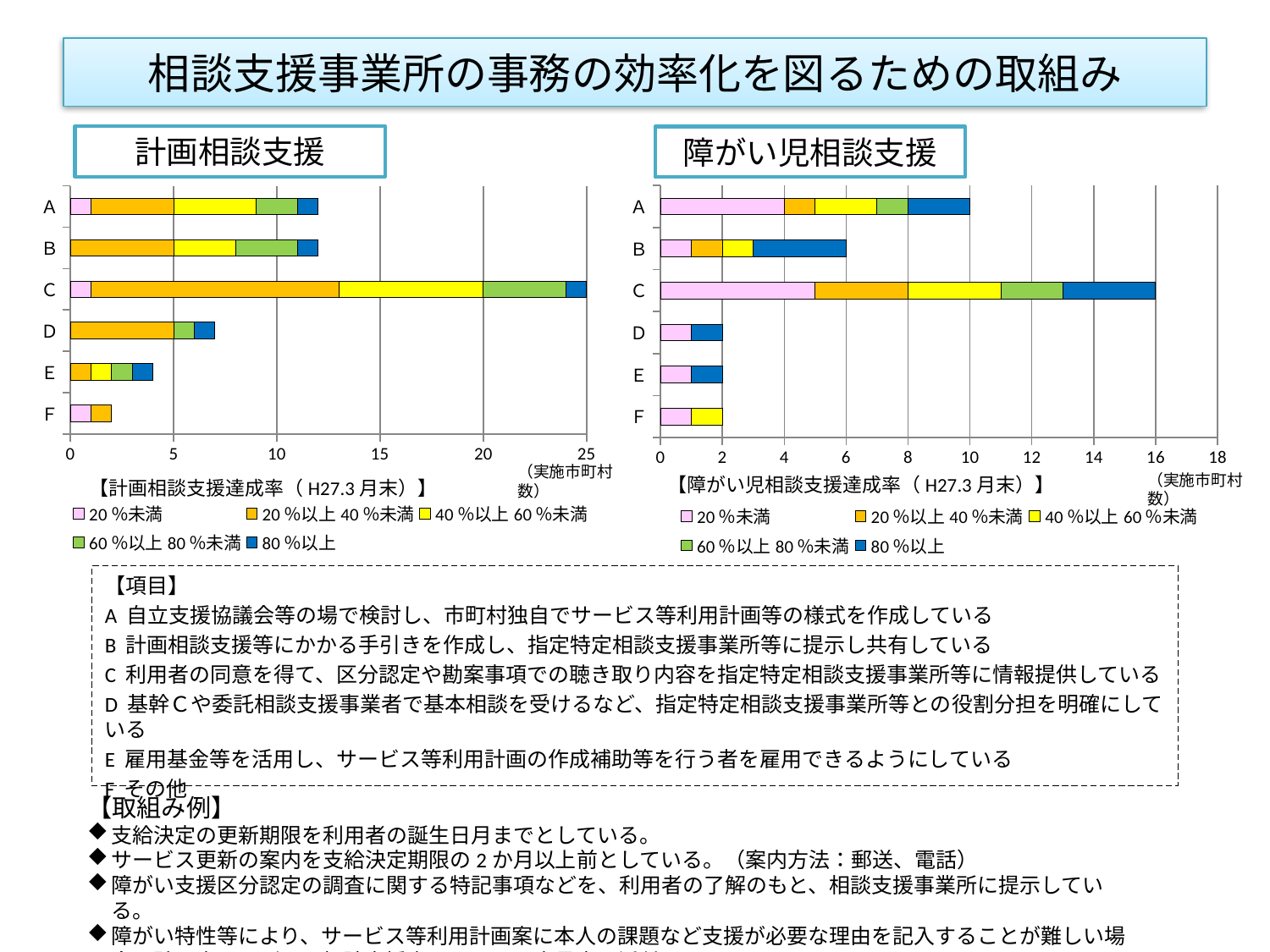
In the 計画相談支援 chart, what is the total length of the stacked bar for C? 25 In the 計画相談支援 chart, which legend entry is shown in pink? 20％未満 In the 障がい児相談支援 chart, what is the total length of the stacked bar for A? 10 How many categories are plotted in the 計画相談支援 chart? 6 In the 計画相談支援 chart, is the total value for A greater or less than 10? greater In the 障がい児相談支援 chart, which has the larger total bar, A or B? A In the 障がい児相談支援 chart, what is the total length of the stacked bar for B? 6 What kind of chart is the 計画相談支援 chart on the left? bar chart In the 計画相談支援 chart, which category has the shortest total bar? F How many series does the legend of the 障がい児相談支援 chart list? 5 In the 計画相談支援 chart, which category has the longest total bar? C